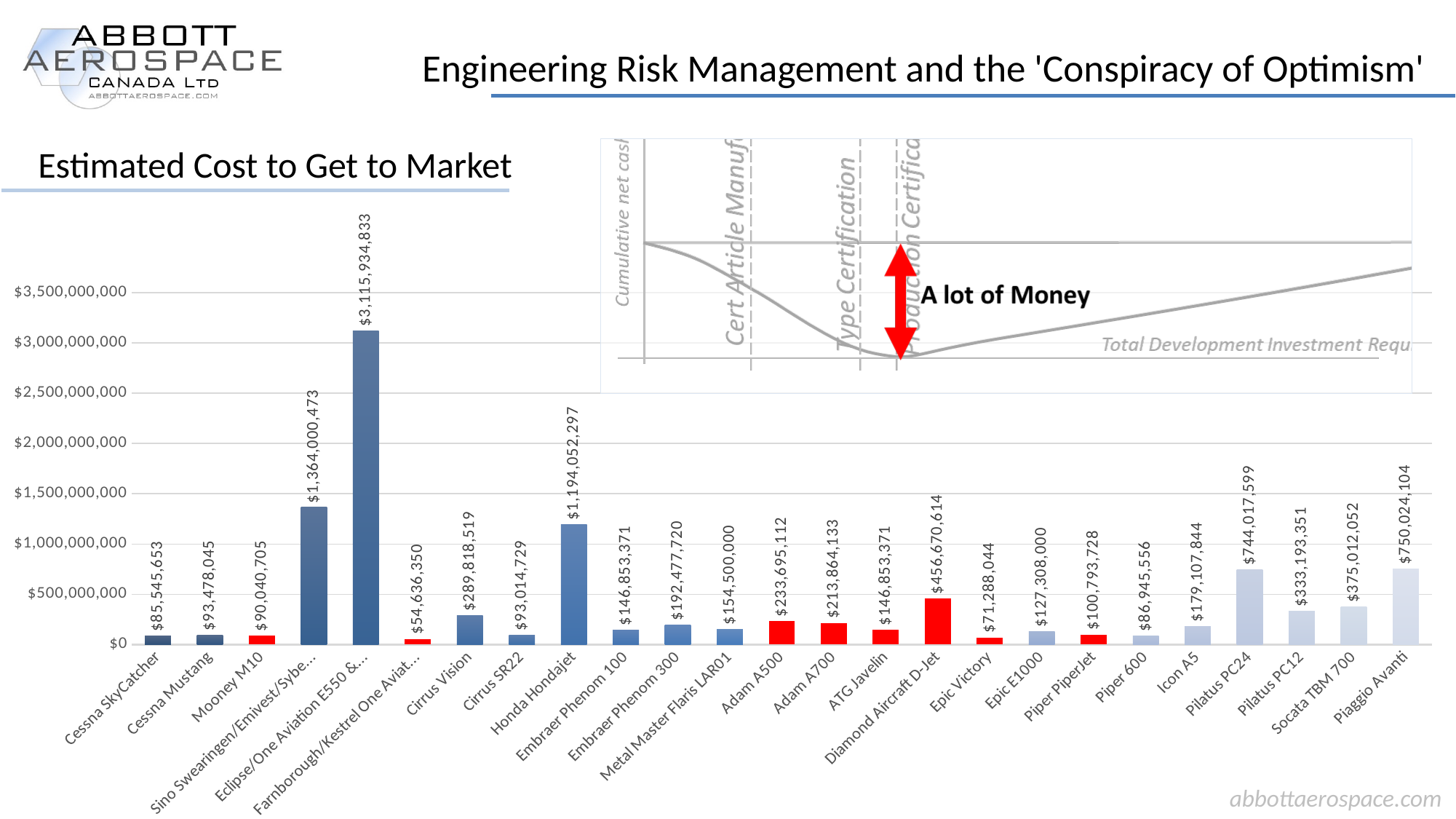
In the 'Estimated Cost to Get to Market' chart, which aircraft has the lowest estimated cost? Farnborough/Kestrel One Aviation In the 'Estimated Cost to Get to Market' chart, is the value for Diamond Aircraft D-Jet greater or less than $500,000,000? less What is the title of the bar chart on the slide? Estimated Cost to Get to Market In the 'Estimated Cost to Get to Market' chart, which aircraft has the highest estimated cost? Eclipse/One Aviation E550 In the 'Estimated Cost to Get to Market' chart, how much larger is the value for Piaggio Avanti than the value for Pilatus PC24? $6,006,505 In the 'Estimated Cost to Get to Market' chart, what is the value for Honda Hondajet? $1,194,052,297 In the 'Estimated Cost to Get to Market' chart, which is larger: Socata TBM 700 or Pilatus PC12? Socata TBM 700 In the 'Estimated Cost to Get to Market' chart, what is the value for Diamond Aircraft D-Jet? $456,670,614 In the 'Estimated Cost to Get to Market' chart, what is the difference between Honda Hondajet and Cirrus Vision? $904,233,778 What kind of chart is the 'Estimated Cost to Get to Market' chart? bar chart In the 'Estimated Cost to Get to Market' chart, what is the value for Pilatus PC24? $744,017,599 How many aircraft categories are shown in the 'Estimated Cost to Get to Market' chart? 25